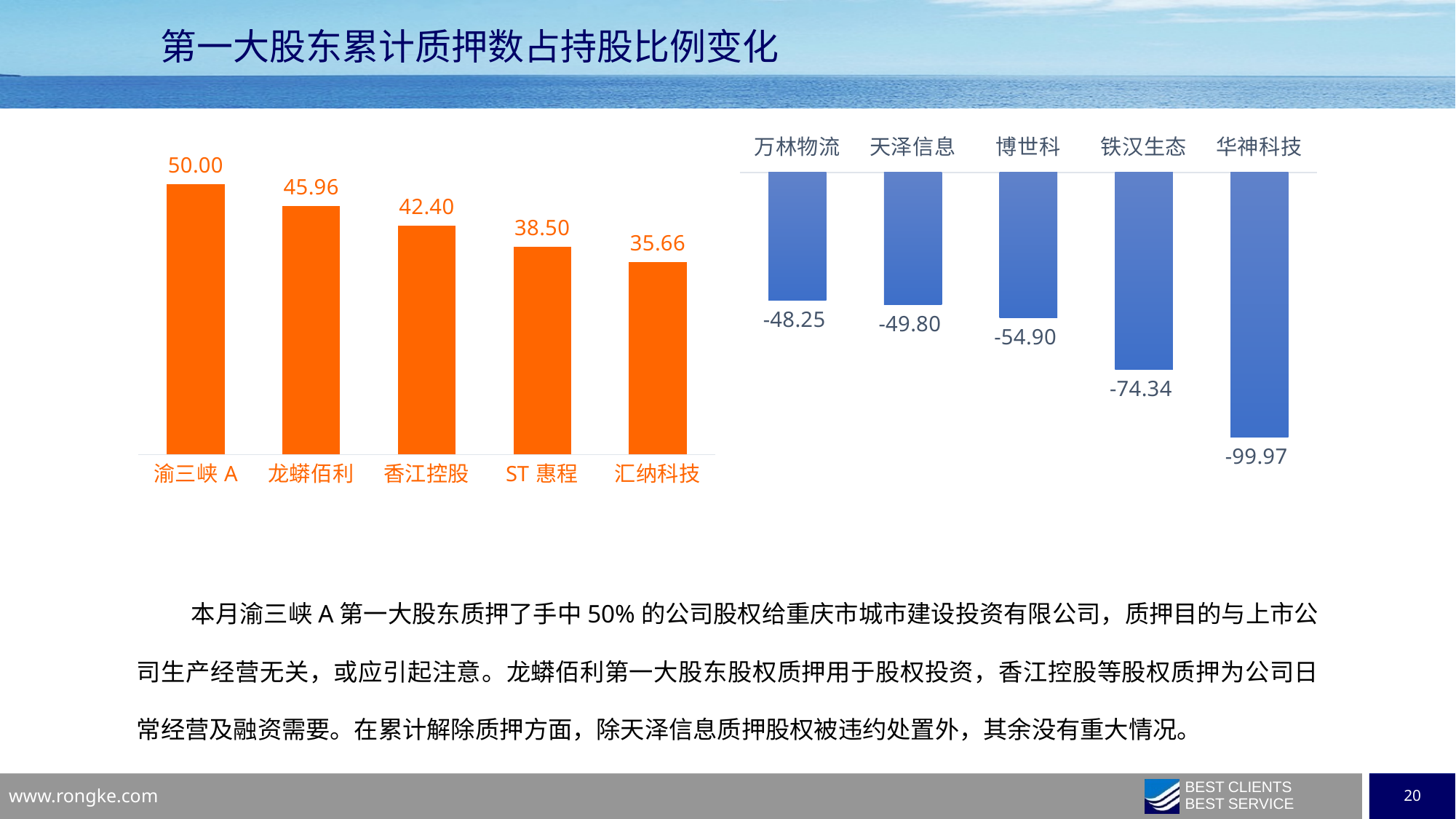
What type of chart is the left chart? bar chart In the right chart, what is the value for 天泽信息? -49.80 How many categories are shown in the right chart? 5 In the left chart, which category has the highest value? 渝三峡 A In the right chart, what is the value for 铁汉生态? -74.34 In the right chart, do the values rise or fall from left to right? fall In the left chart, what is the difference between the values for 渝三峡 A and ST 惠程? 11.50 In the left chart, which is larger, the value for 香江控股 or the value for ST 惠程? 香江控股 In the left chart, what is the value for 龙蟒佰利? 45.96 In the right chart, which category has the lowest value? 华神科技 In the right chart, what is the difference between the values for 万林物流 and 博世科? 6.65 In the left chart, what is the value for 汇纳科技? 35.66